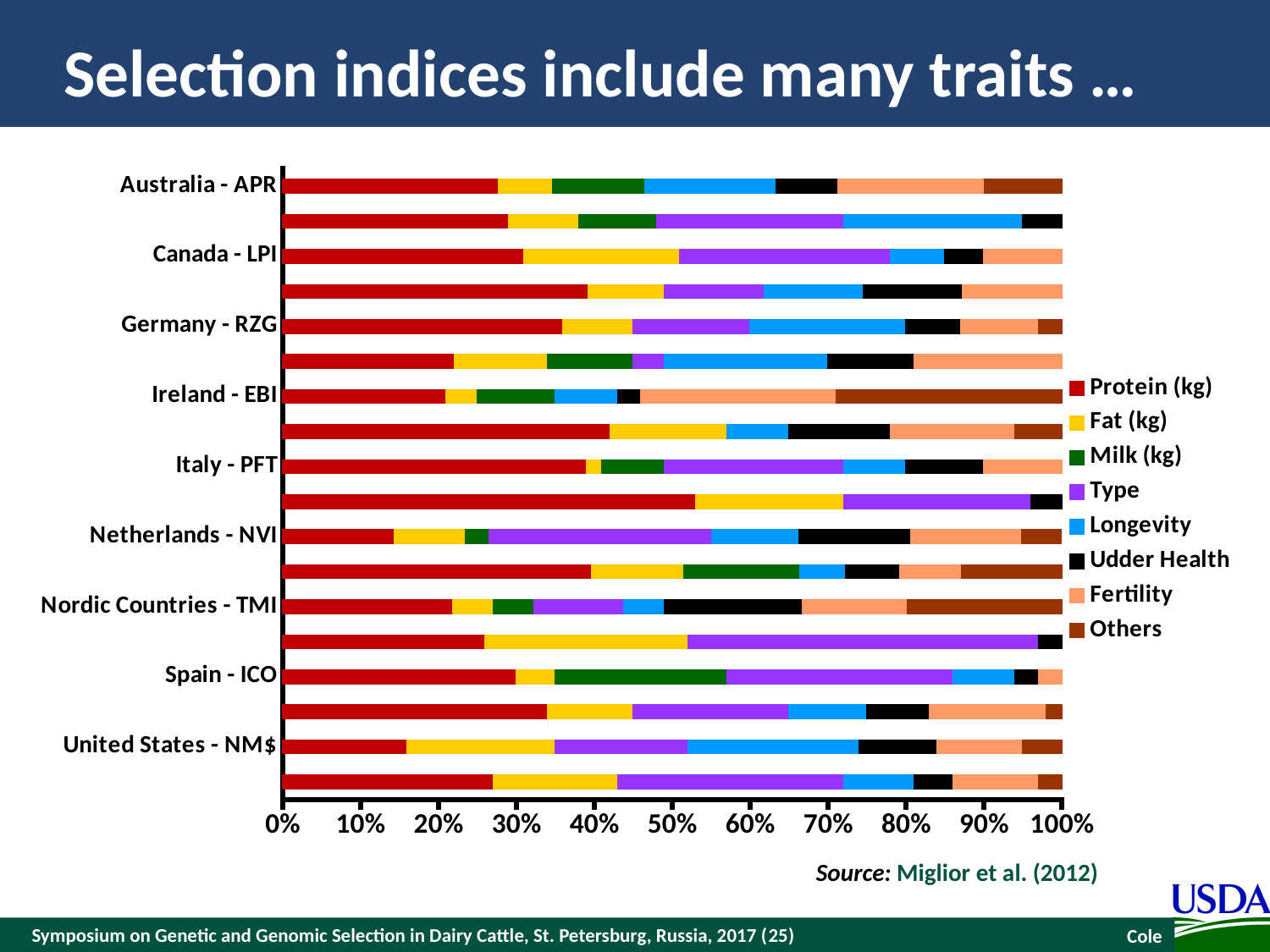
How many country/index labels appear on the vertical axis? 9 What is the title of the slide? Selection indices include many traits ... Is the Others share for Ireland - EBI greater or less than 20%? greater Is the Protein (kg) share for Italy - PFT greater or less than 30%? greater Is the Protein (kg) share for Netherlands - NVI greater or less than 20%? less Which has the larger Others share, Ireland - EBI or Australia - APR? Ireland - EBI Which series is listed first in the legend? Protein (kg) Which has the larger Protein (kg) share, Italy - PFT or Netherlands - NVI? Italy - PFT What kind of chart is shown on the slide? Stacked bar chart How many series does the legend list? 8